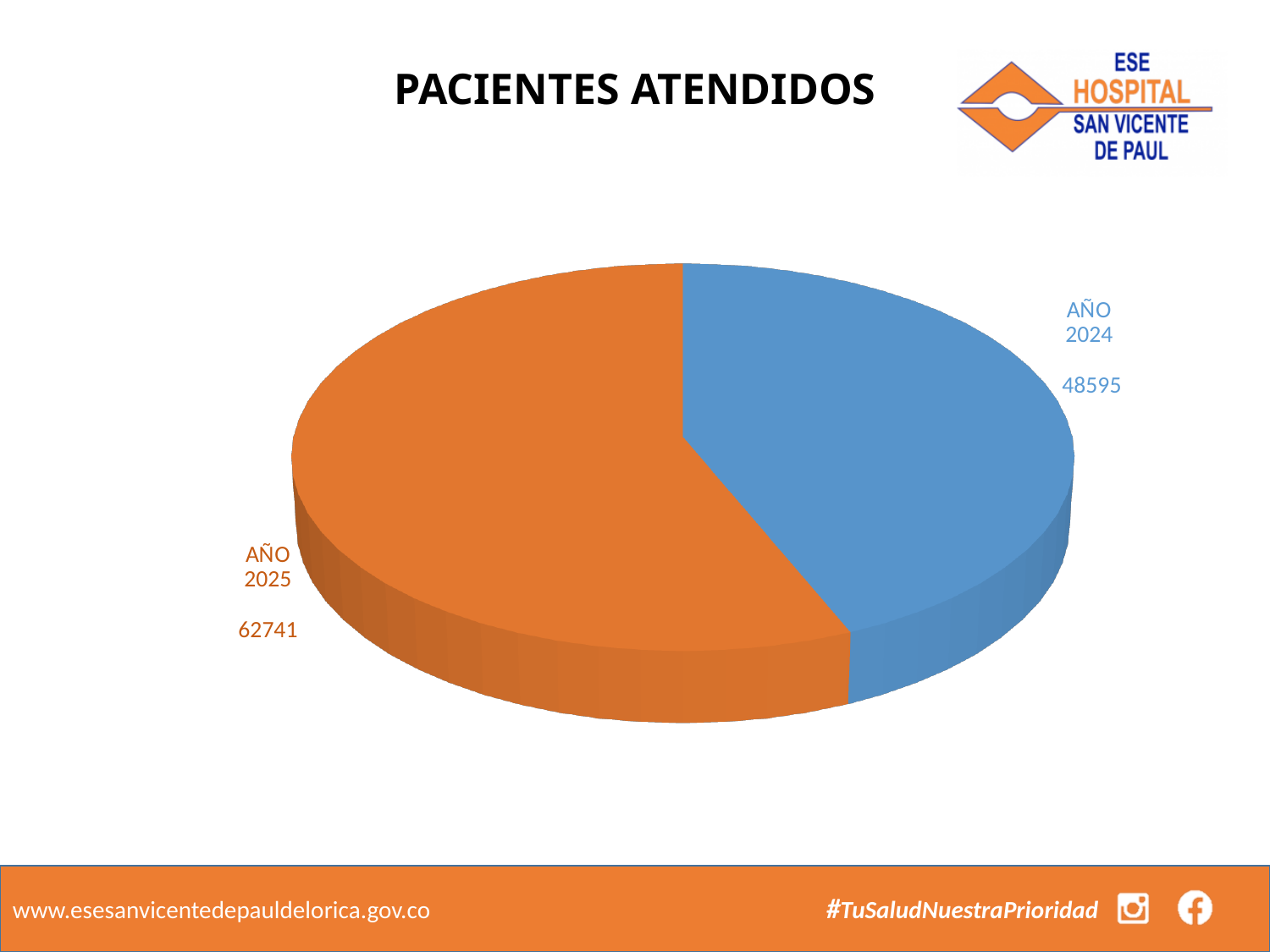
Which year has the largest slice of the pie? AÑO 2025 Which is larger, the value for AÑO 2024 or AÑO 2025? AÑO 2025 How many slices does the pie chart have? 2 What is the value for AÑO 2024? 48595 What is the total of the two slices in the pie chart? 111336 What is the difference between the values for AÑO 2025 and AÑO 2024? 14146 What share of the pie does AÑO 2025 represent, to one decimal place? 56.4% What is the value for AÑO 2025? 62741 Which year has the smallest slice of the pie? AÑO 2024 What is the title of the chart? PACIENTES ATENDIDOS What type of chart is shown on the slide? Pie chart What colour is the slice for AÑO 2024? Blue